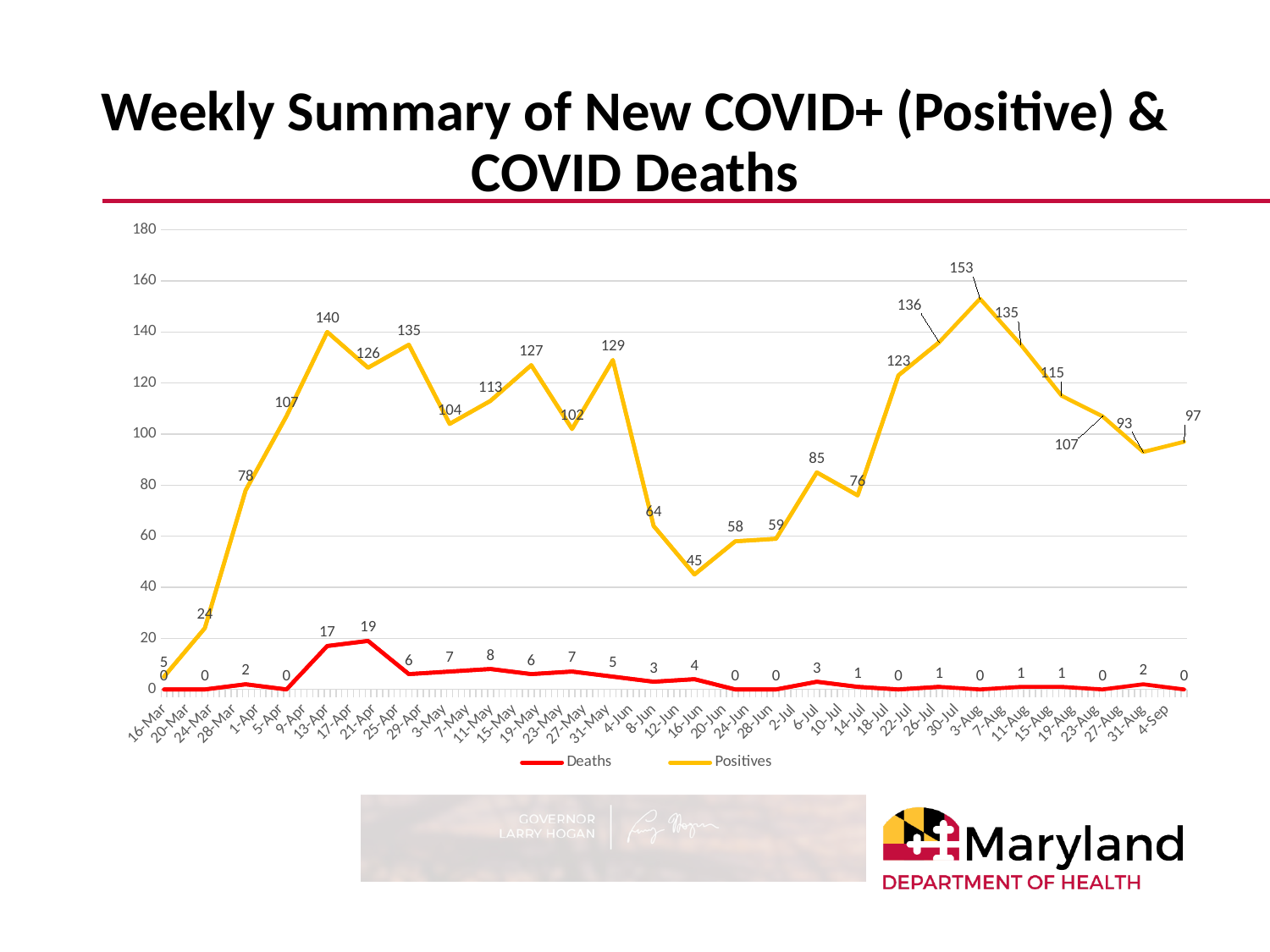
What are the two series named in the legend? Deaths and Positives What is the highest value on the Positives line? 153 What colour is the Positives line? Yellow What is the difference between the Positives peak of 153 and the earlier peak of 140? 13 Which is larger on the Deaths line, the 17 point or the 19 point that follows it? 19 What kind of chart is shown on the slide? Line chart How many series does the legend list? 2 What is the Positives value at 4-Sep? 97 What is the highest value on the Deaths line? 19 What is the lowest labelled value on the Positives line? 5 What is the Deaths value at 16-Mar? 0 Do the Positives values rise or fall from the 153 peak to the 93 point? Fall